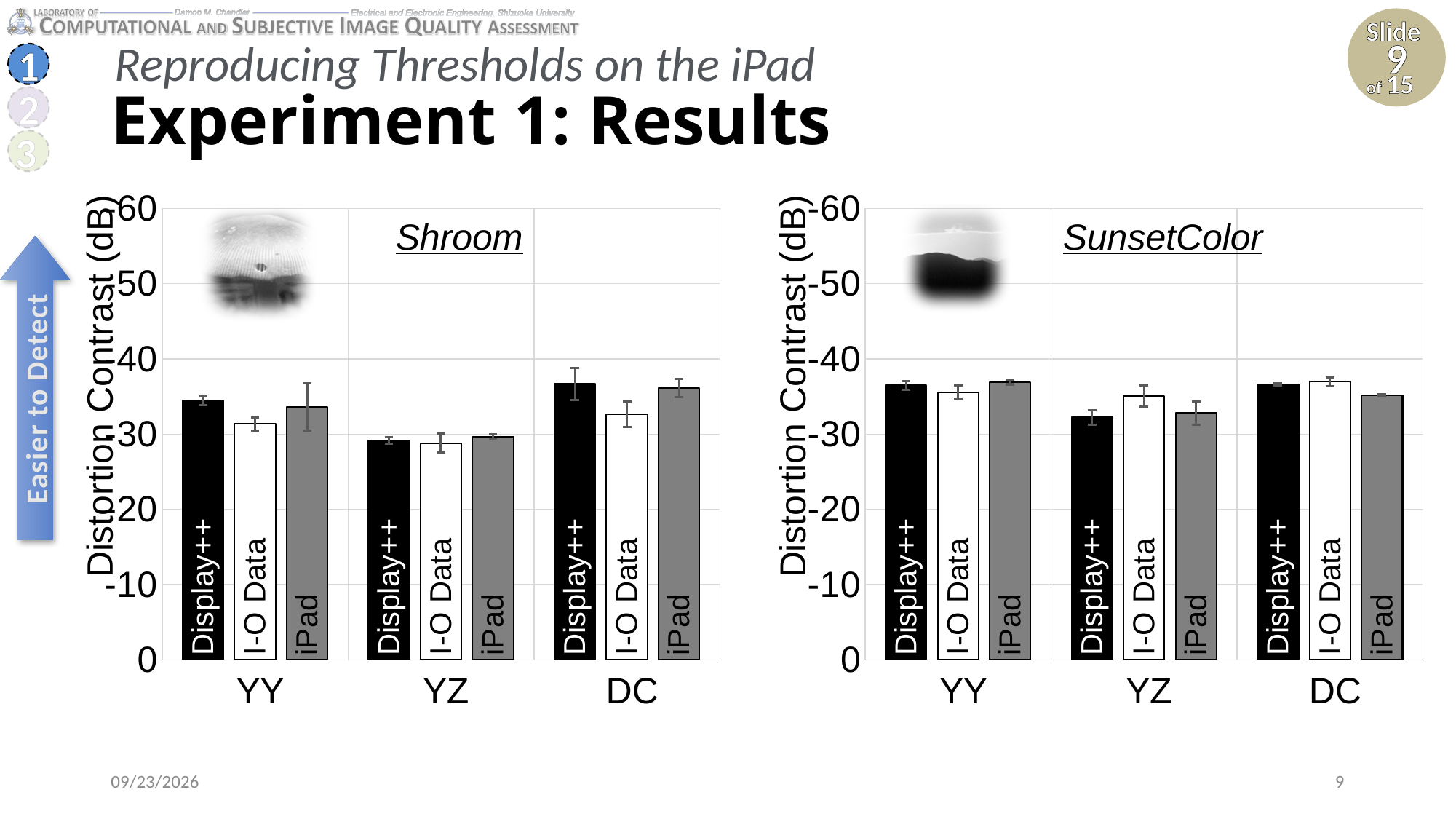
In the SunsetColor chart, which category has the shortest iPad bar? YZ How many bars (series) are shown for each category in the Shroom chart? 3 What are the titles of the two charts on the slide? Shroom and SunsetColor In the Shroom chart, which category has the shortest bars overall? YZ In the Shroom chart, for category YY, which bar is taller: Display++ or I-O Data? Display++ In the Shroom chart, which category has the tallest Display++ bar? DC In the Shroom chart, is the value for Display++ in category DC greater or less than -40? greater In the SunsetColor chart, is the value for I-O Data in category YY greater or less than -40? greater What kind of chart is the Shroom chart? bar chart In the SunsetColor chart, for category YZ, which bar is taller: Display++ or I-O Data? I-O Data How many categories are shown on the x axis of the SunsetColor chart? 3 What is the y-axis title of the Shroom chart? Distortion Contrast (dB)